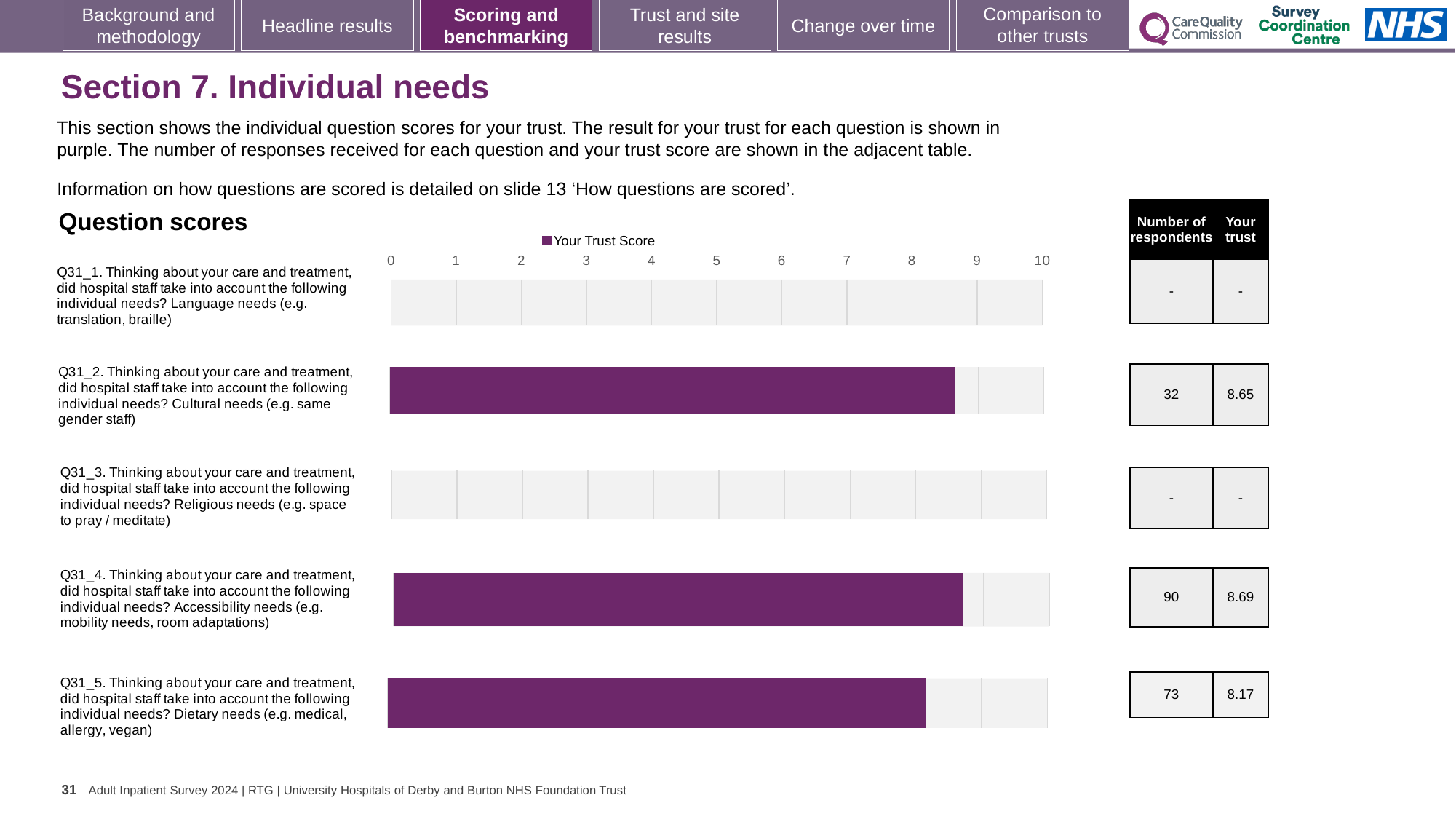
On the Q31_5 (Dietary needs) chart, what is the Your Trust Score value? 8.17 On the Q31_5 (Dietary needs) chart, is the trust score greater or less than 9? less On the Q31_2 (Cultural needs) chart, what is the Your Trust Score value? 8.65 What is the difference between the trust scores for Q31_4 (Accessibility needs) and Q31_5 (Dietary needs)? 0.52 What series name is shown in the legend above the question score charts? Your Trust Score What is the difference between the trust scores for Q31_2 (Cultural needs) and Q31_5 (Dietary needs)? 0.48 On the Q31_4 (Accessibility needs) chart, what is the Your Trust Score value? 8.69 Among the questions with a plotted bar, which has the lowest trust score? Q31_5 (Dietary needs) Which is larger: the trust score for Q31_4 (Accessibility needs) or for Q31_5 (Dietary needs)? Q31_4 (Accessibility needs) What type of chart is used to show the question scores on this slide? Bar chart How many of the five question charts on the slide show a plotted bar? 3 Across the question score charts on the slide, which question has the highest trust score? Q31_4 (Accessibility needs)